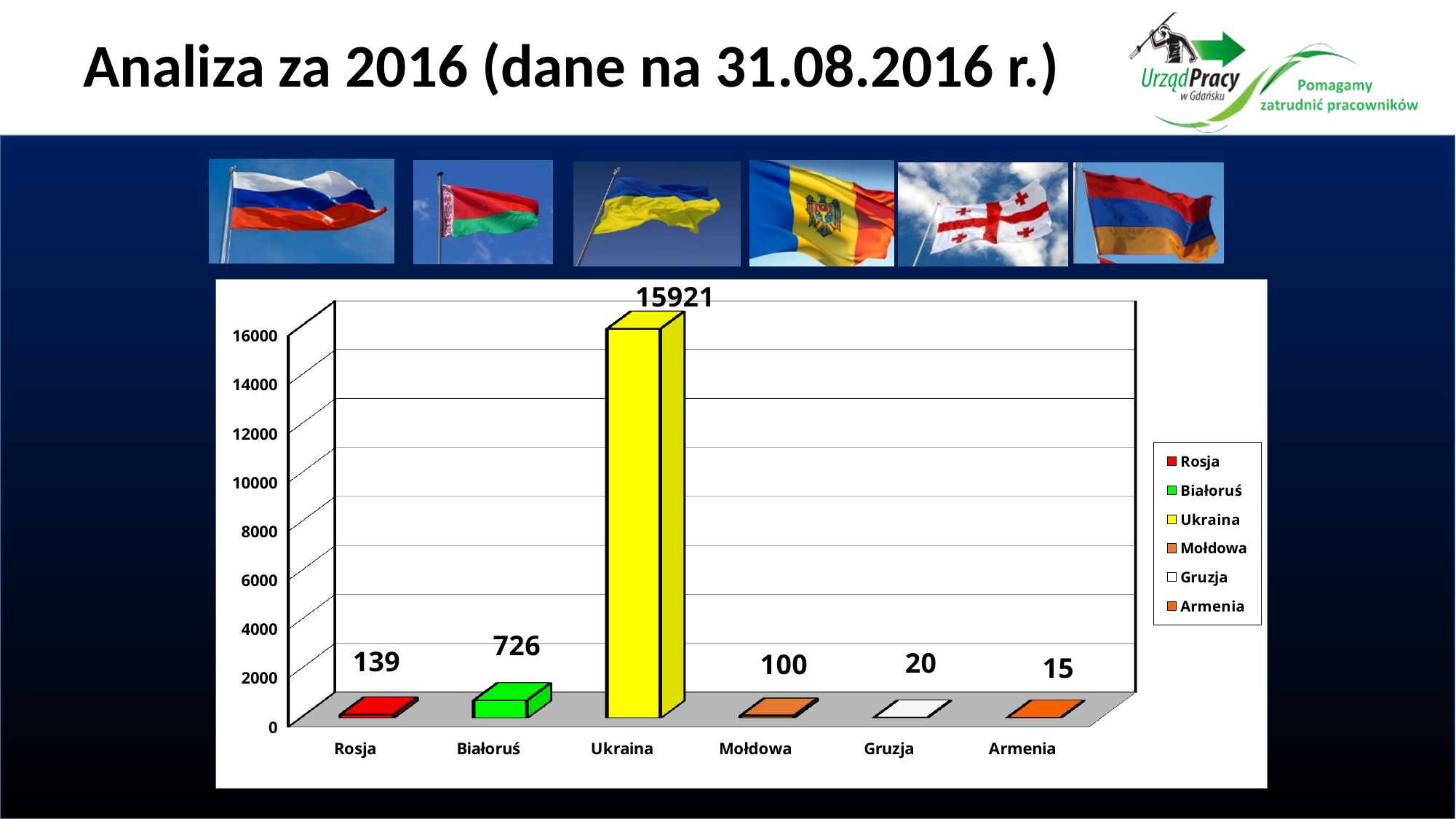
Which category has the highest value? Ukraina How many categories are shown on the x axis? 6 What is the value for Armenia? 15 What is the value for Rosja? 139 Which category has the lowest value? Armenia What kind of chart is shown on the slide? bar chart What colour is the bar for Ukraina? yellow Which is larger, the value for Mołdowa or the value for Gruzja? Mołdowa What is the value for Białoruś? 726 What is the difference between the values for Białoruś and Rosja? 587 What is the value for Ukraina? 15921 Is the value for Ukraina greater or less than 14000? greater